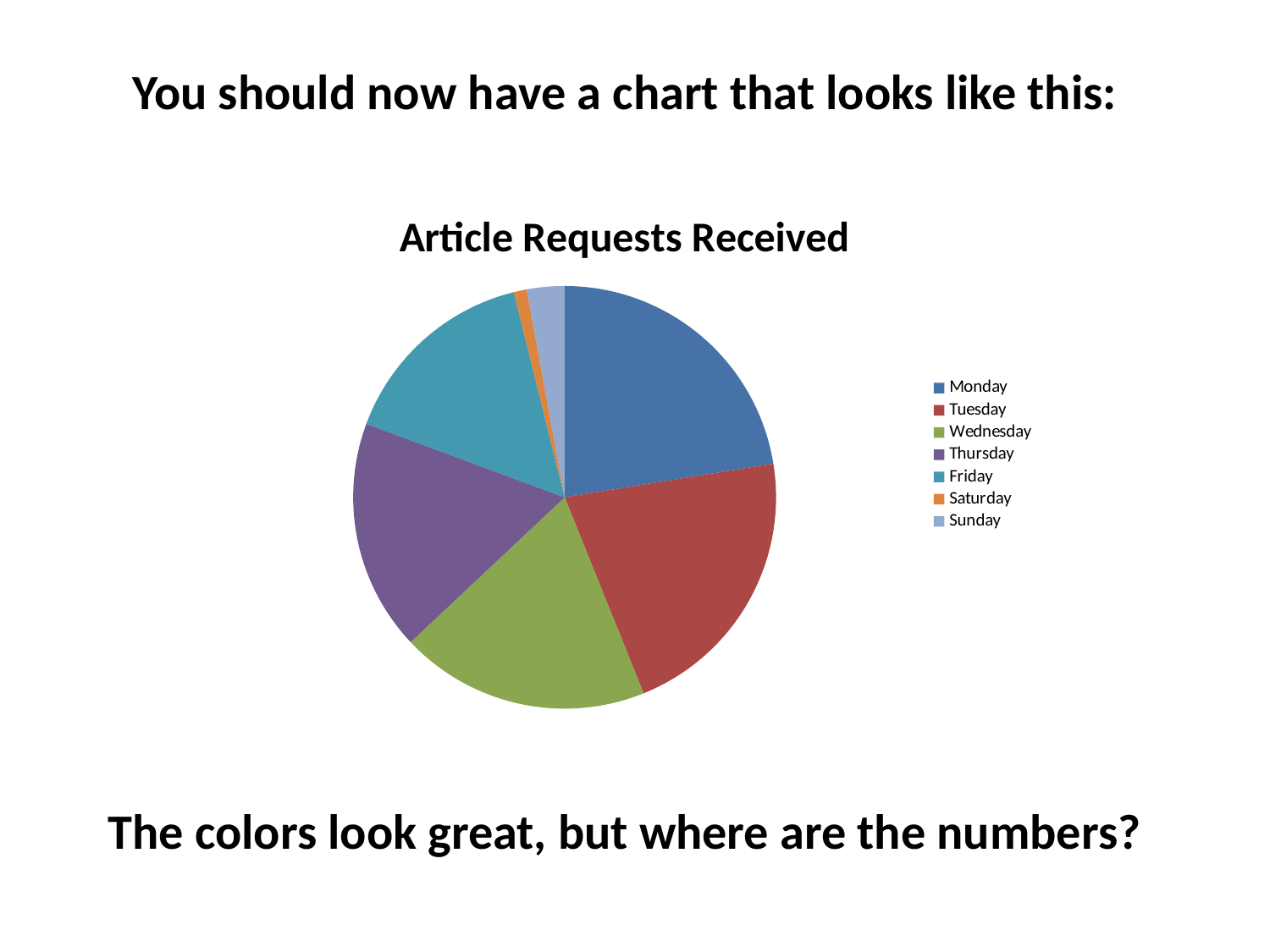
How many categories (slices) does the pie chart have? 7 What kind of chart is shown on the slide? pie chart Which day has the smallest slice of the pie? Saturday How many entries does the legend list? 7 Are any data labels or values printed on the pie slices? No What is the title of the chart? Article Requests Received Which slice is larger, Monday or Friday? Monday Which slice is larger, Thursday or Saturday? Thursday Which legend entry is listed first? Monday Which slice is larger, Tuesday or Sunday? Tuesday